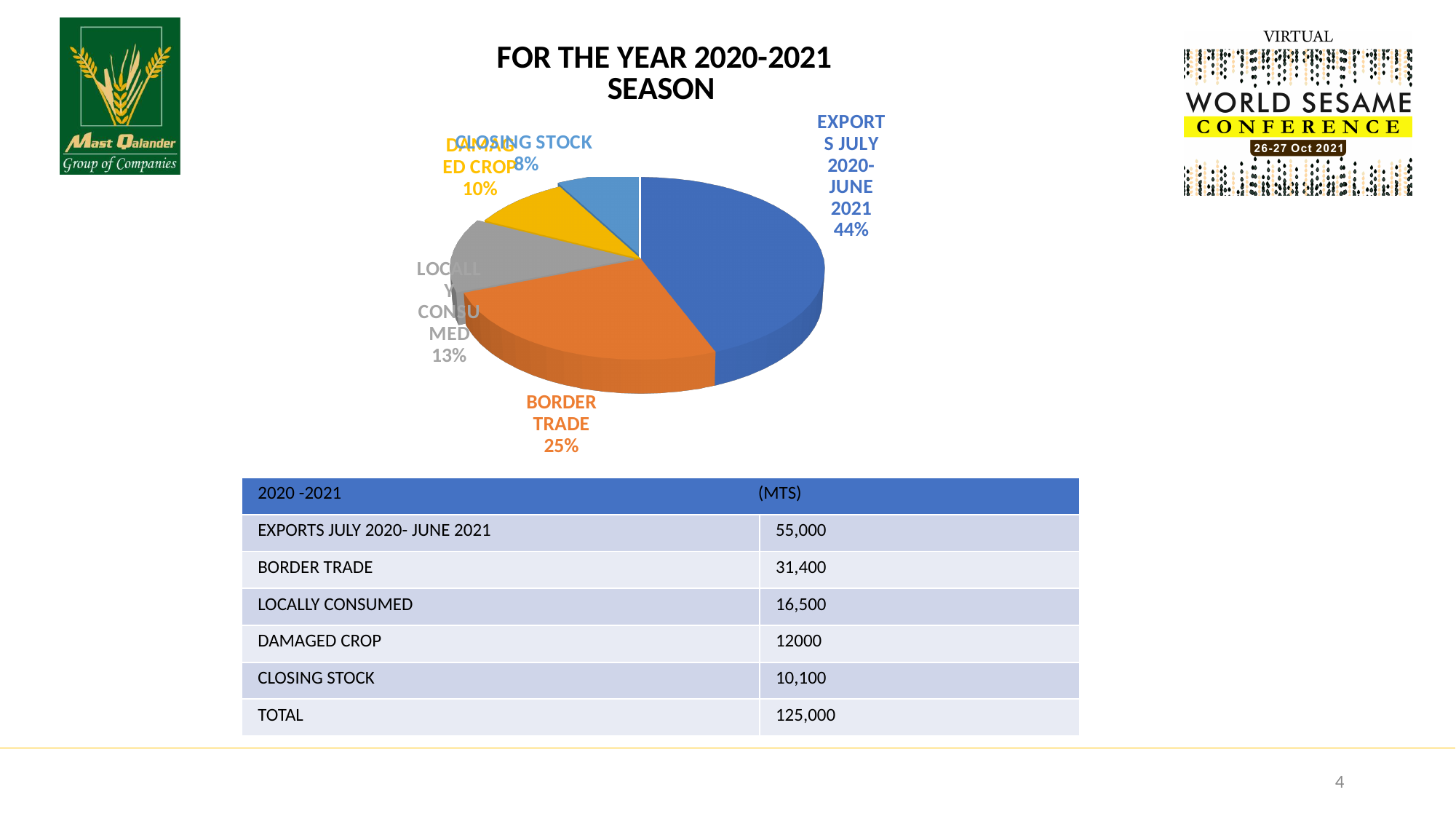
Which slice is larger, BORDER TRADE or LOCALLY CONSUMED? BORDER TRADE What share of the pie does LOCALLY CONSUMED represent? 13% By how many percentage points does the EXPORTS JULY 2020-JUNE 2021 share exceed the BORDER TRADE share? 19 percentage points Which slice of the pie chart is the smallest? CLOSING STOCK What share of the pie does DAMAGED CROP represent? 10% Which slice of the pie chart is the largest? EXPORTS JULY 2020-JUNE 2021 What kind of chart is shown on the slide? Pie chart What share of the pie does CLOSING STOCK represent? 8% What is the title of the pie chart? FOR THE YEAR 2020-2021 SEASON How many slices does the pie chart have? 5